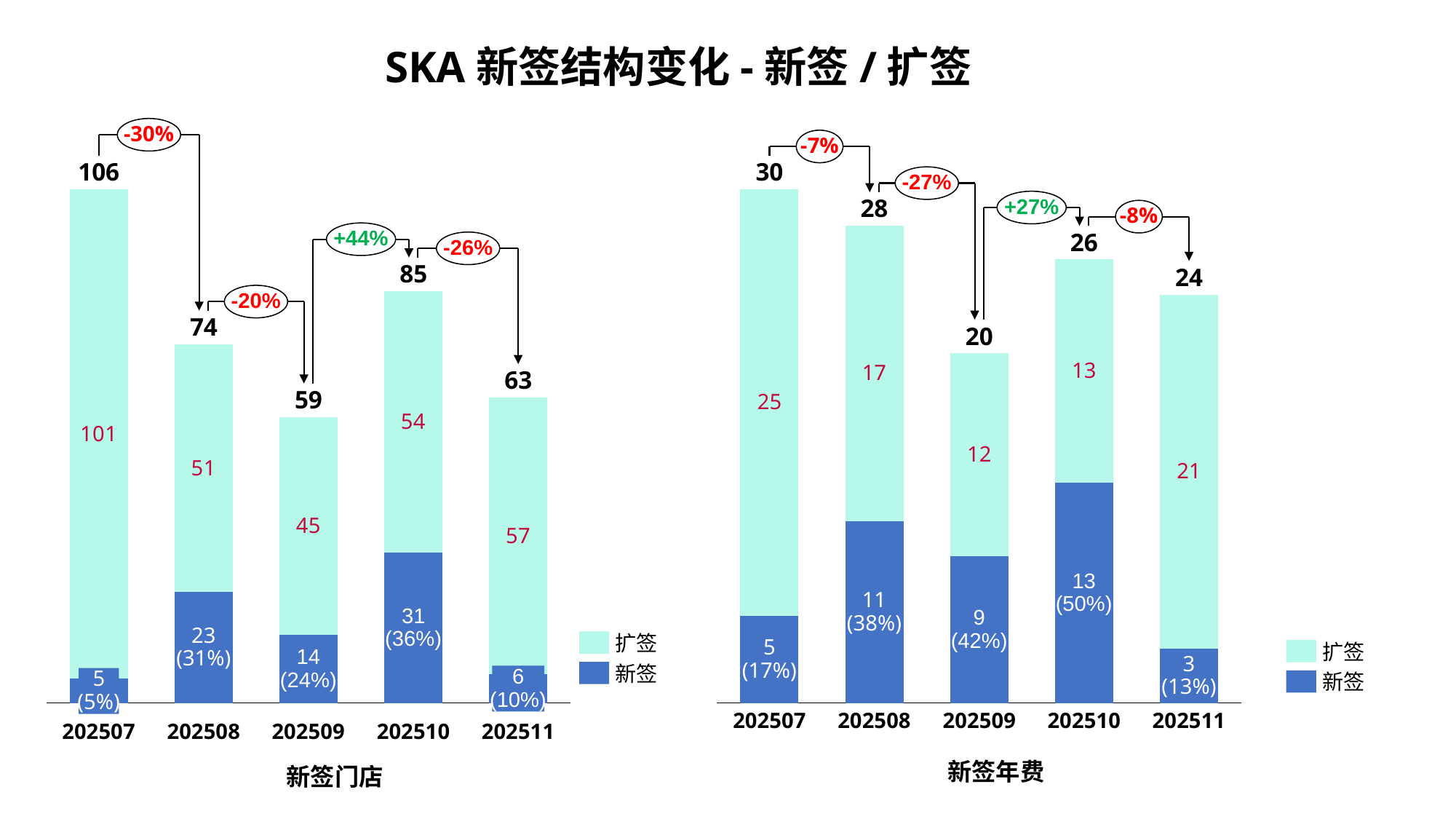
In the 新签门店 chart (left), what is the total of the stacked bar for 202508? 74 In the 新签门店 chart (left), which month has the lowest total? 202509 In the 新签年费 chart (right), which month has the lowest total? 202509 In the 新签年费 chart (right), is the 新签 value for 202508 larger or smaller than the 新签 value for 202509? larger In the 新签门店 chart (left), what is the difference between the totals for 202510 and 202511? 22 In the 新签年费 chart (right), what is the 扩签 value for 202511? 21 In the 新签门店 chart (left), what is the 新签 value for 202510? 31 In the 新签年费 chart (right), what is the total of the stacked bar for 202510? 26 How many months are shown on the x axis of the 新签年费 chart (right)? 5 In the 新签门店 chart (left), which month has the highest total? 202507 In the 新签门店 chart (left), what is the 扩签 value for 202507? 101 How many series does the legend of the 新签门店 chart (left) list? 2